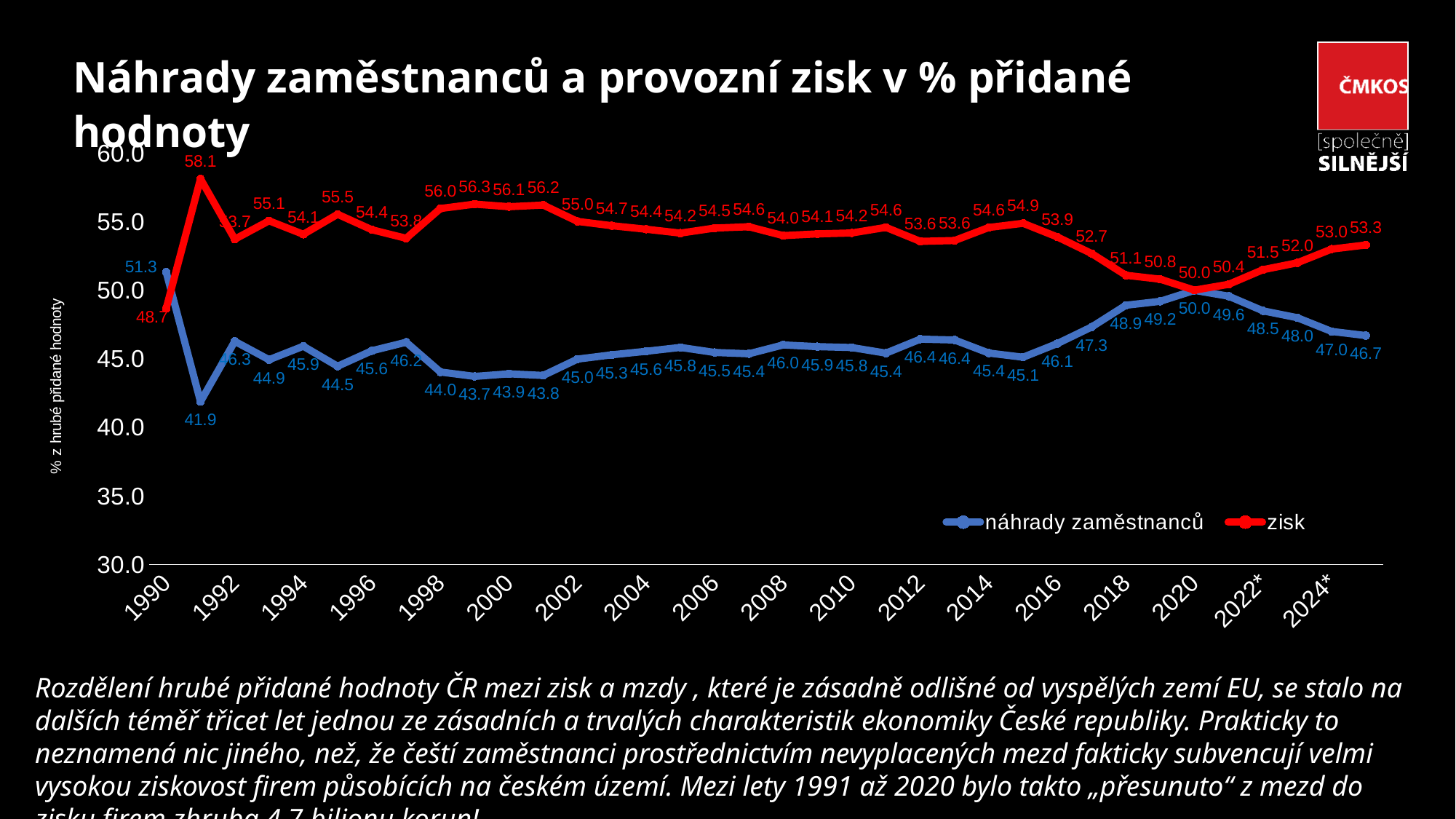
Which series has the larger value in 1990, 'náhrady zaměstnanců' or 'zisk'? náhrady zaměstnanců What is the value of 'zisk' in 1990? 48.7 What is the label of the vertical axis? % z hrubé přidané hodnoty How many series does the legend list? 2 What kind of chart is shown on the slide? line chart What is the value of 'náhrady zaměstnanců' in 1990? 51.3 What is the lowest value of the 'náhrady zaměstnanců' series? 41.9 Does the 'náhrady zaměstnanců' series rise or fall from 2020 to 2024*? fall In which year does the 'zisk' series reach its highest value? 1991 What is the highest value of the 'zisk' series? 58.1 What is the difference between 'zisk' and 'náhrady zaměstnanců' in 1991? 16.2 What is the difference between 'náhrady zaměstnanců' and 'zisk' in 1990? 2.6